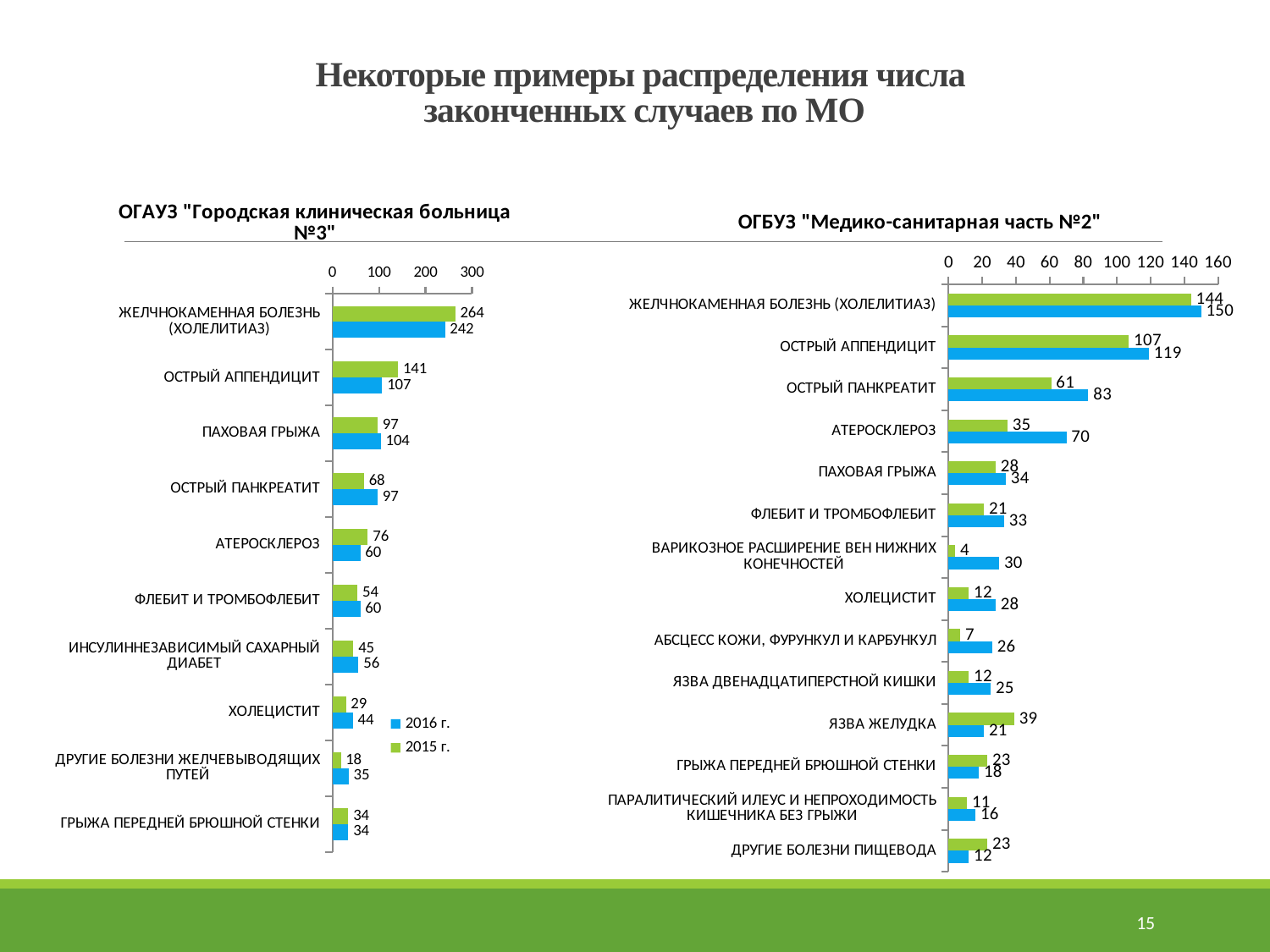
In the chart titled ОГБУЗ "Медико-санитарная часть №2", what is the value of the blue bar for АТЕРОСКЛЕРОЗ? 70 In the chart titled ОГАУЗ "Городская клиническая больница №3", what is the 2015 г. value for АТЕРОСКЛЕРОЗ? 76 In the chart titled ОГАУЗ "Городская клиническая больница №3", what is the difference between the 2015 г. and 2016 г. values for ЖЕЛЧНОКАМЕННАЯ БОЛЕЗНЬ (ХОЛЕЛИТИАЗ)? 22 In the chart titled ОГБУЗ "Медико-санитарная часть №2", how many categories are shown? 14 In the chart titled ОГБУЗ "Медико-санитарная часть №2", which is larger for ЯЗВА ЖЕЛУДКА, the green bar or the blue bar? the green bar In the chart titled ОГБУЗ "Медико-санитарная часть №2", which category has the lowest blue bar value? ДРУГИЕ БОЛЕЗНИ ПИЩЕВОДА In the chart titled ОГАУЗ "Городская клиническая больница №3", what is the 2016 г. value for ОСТРЫЙ АППЕНДИЦИТ? 107 In the chart titled ОГБУЗ "Медико-санитарная часть №2", what is the value of the green bar for ВАРИКОЗНОЕ РАСШИРЕНИЕ ВЕН НИЖНИХ КОНЕЧНОСТЕЙ? 4 In the chart titled ОГАУЗ "Городская клиническая больница №3", how many categories are shown? 10 What type of chart is the one titled ОГБУЗ "Медико-санитарная часть №2"? bar chart In the chart titled ОГАУЗ "Городская клиническая больница №3", how many series does the legend list? 2 In the chart titled ОГАУЗ "Городская клиническая больница №3", which category has the highest 2015 г. value? ЖЕЛЧНОКАМЕННАЯ БОЛЕЗНЬ (ХОЛЕЛИТИАЗ)